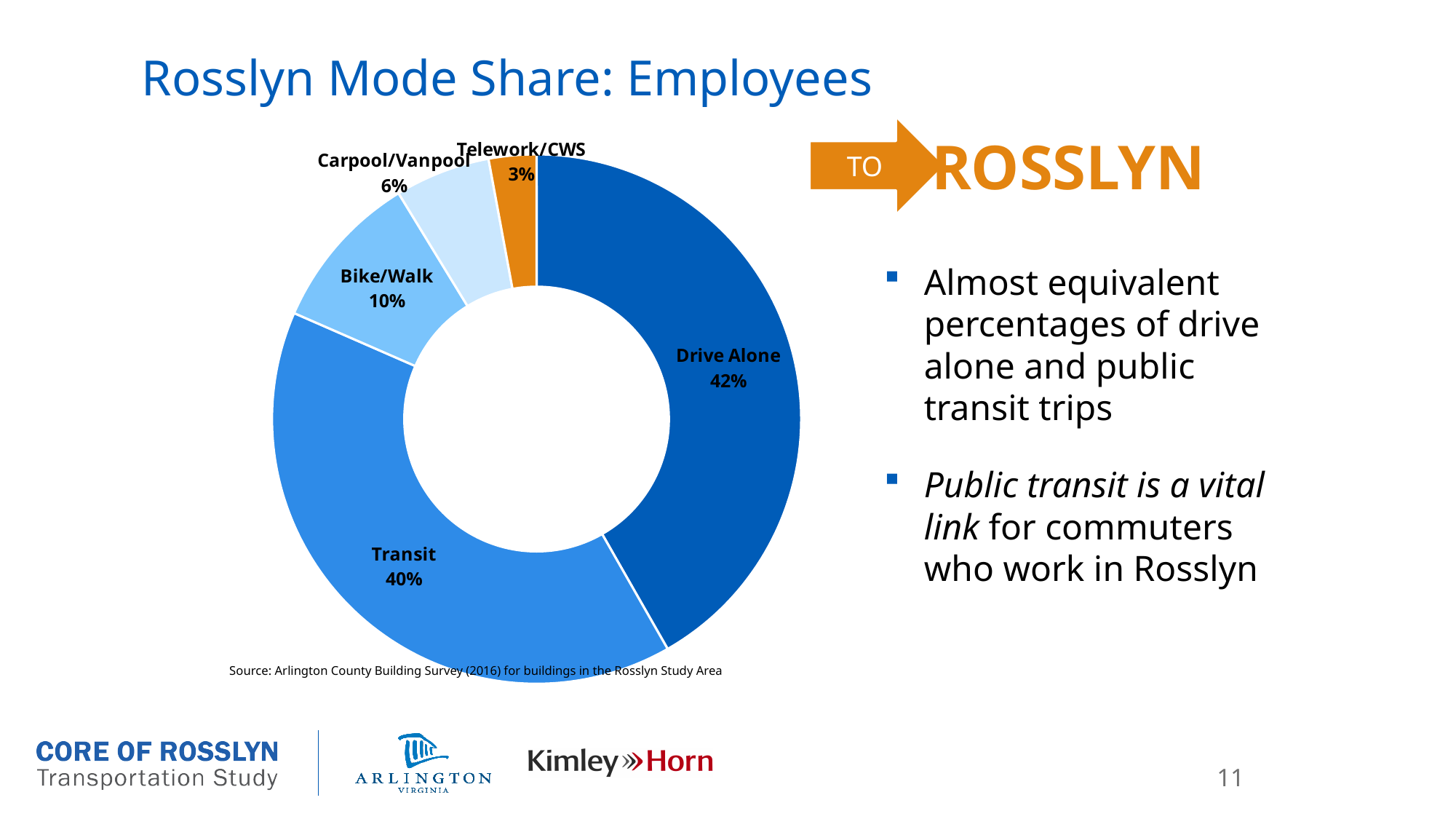
What percentage of employees use transit? 40% What is the share for Bike/Walk? 10% What is the difference in percentage points between Drive Alone and Transit? 2 percentage points What kind of chart is shown on the slide? Doughnut (pie) chart What is the share for Carpool/Vanpool? 6% What is the share for Telework/CWS? 3% How many mode categories are shown in the chart? 5 Which is larger, the Bike/Walk share or the Carpool/Vanpool share? Bike/Walk Which mode has the smallest share? Telework/CWS Which slice of the chart is coloured orange? Telework/CWS What share of employees drive alone? 42% Which mode has the largest share? Drive Alone